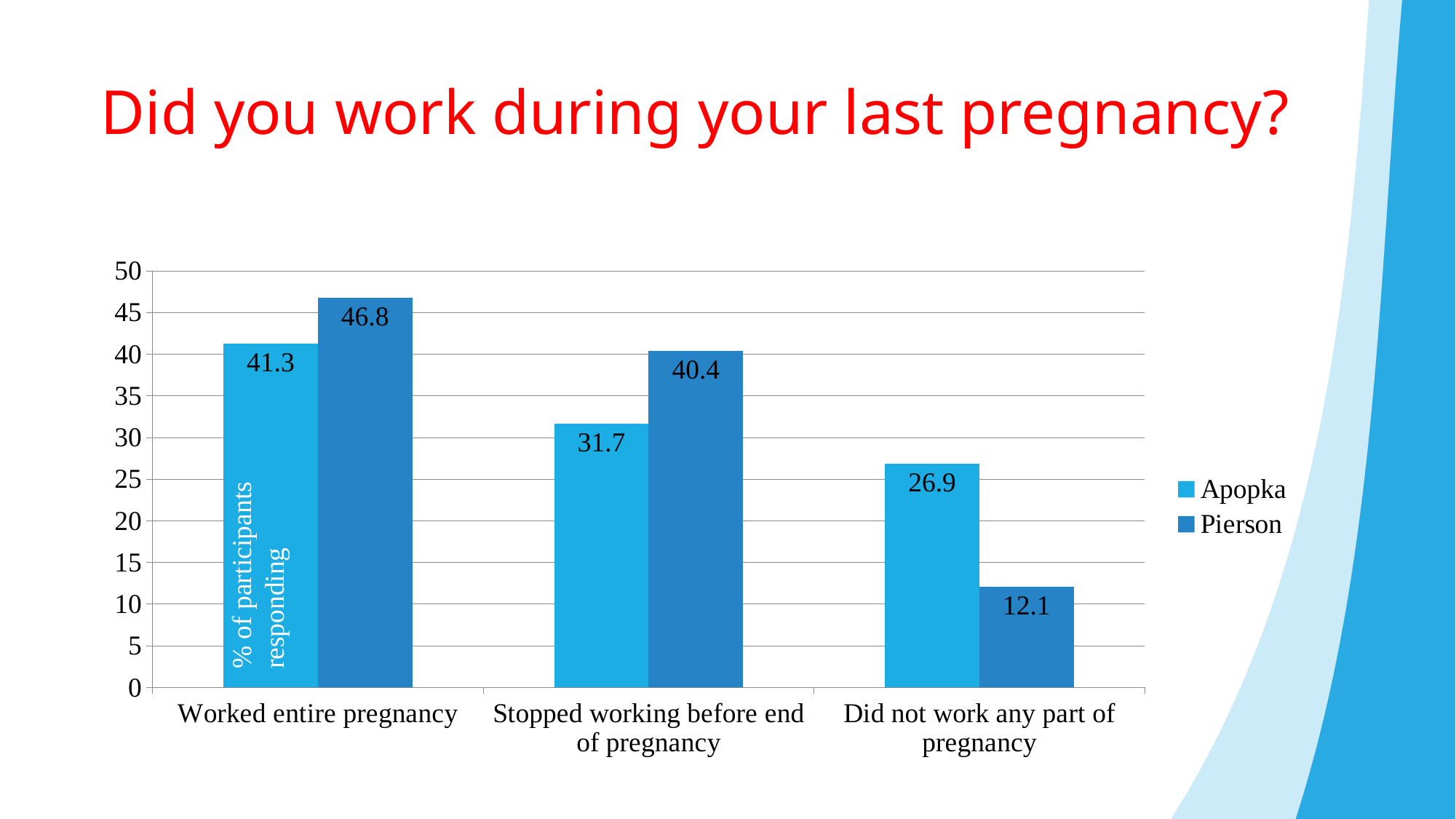
How many categories are shown on the x axis? 3 What is the Apopka value for "Worked entire pregnancy"? 41.3 How many series does the legend list? 2 Which category has the lowest Apopka value? Did not work any part of pregnancy What is the Pierson value for "Did not work any part of pregnancy"? 12.1 What kind of chart is shown on the slide? Bar chart Which category has the highest Pierson value? Worked entire pregnancy Is the Apopka value for "Stopped working before end of pregnancy" greater or less than 30? greater What is the difference between the Pierson and Apopka values for "Worked entire pregnancy"? 5.5 For "Stopped working before end of pregnancy", which series has the larger value, Apopka or Pierson? Pierson What is the difference between the Apopka and Pierson values for "Did not work any part of pregnancy"? 14.8 What is the Pierson value for "Stopped working before end of pregnancy"? 40.4